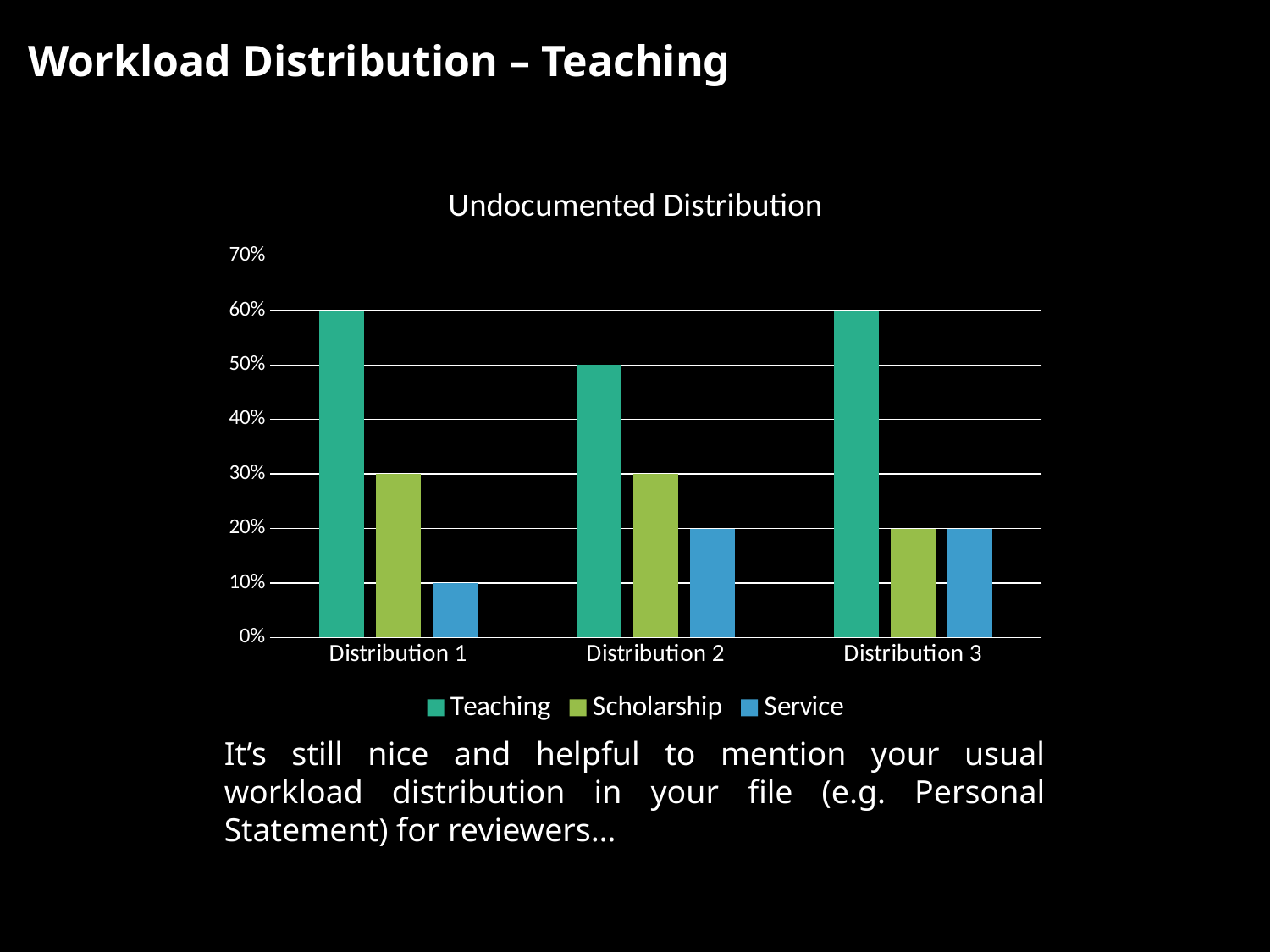
What is the Teaching value for Distribution 1? 60% What is the difference between the Teaching and Scholarship values for Distribution 2? 20% What is the Teaching value for Distribution 2? 50% What is the title of the chart? Undocumented Distribution What is the Scholarship value for Distribution 3? 20% What is the Service value for Distribution 1? 10% Which category has the lowest Service value? Distribution 1 How many series does the legend list? 3 What kind of chart is shown on the slide? bar chart Which category has the lowest Teaching value? Distribution 2 Is the Scholarship value for Distribution 1 larger or smaller than the Scholarship value for Distribution 3? larger How many categories are shown on the x axis? 3